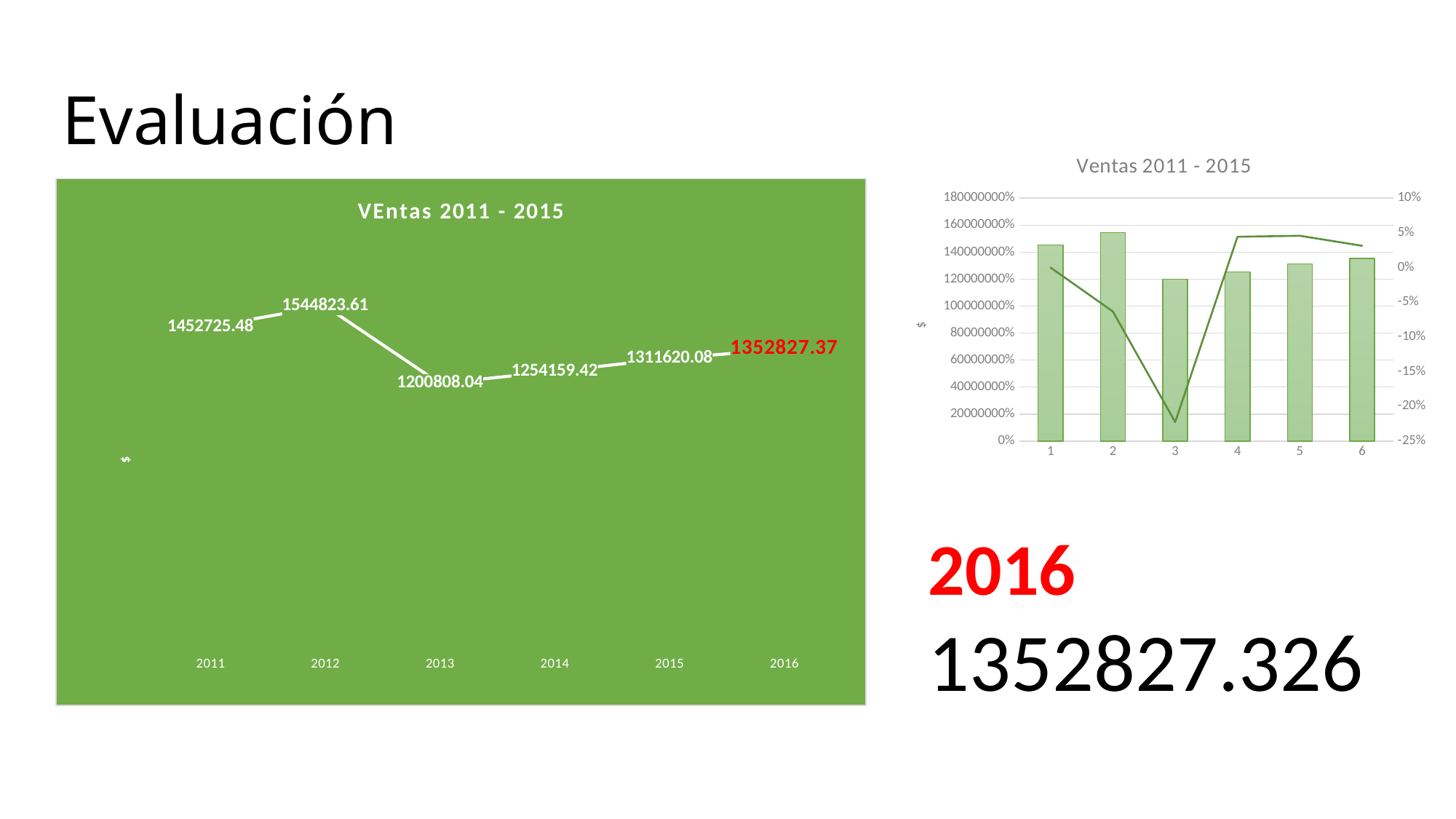
In the right chart titled 'Ventas 2011 - 2015', which category has the tallest bar? 2 In the left chart titled 'VEntas 2011 - 2015', which year has the highest value? 2012 In the left chart titled 'VEntas 2011 - 2015', how many years are plotted on the x axis? 6 In the right chart titled 'Ventas 2011 - 2015', is the bar for category 2 greater or less than 140000000%? greater In the left chart titled 'VEntas 2011 - 2015', do the values rise or fall from 2013 to 2016? Rise In the left chart titled 'VEntas 2011 - 2015', which is larger, the value for 2014 or the value for 2015? 2015 In the left chart titled 'VEntas 2011 - 2015', what is the value for 2016? 1352827.37 In the left chart titled 'VEntas 2011 - 2015', what is the difference between the 2012 and 2011 values? 92098.13 In the left chart titled 'VEntas 2011 - 2015', which year has the lowest value? 2013 In the left chart titled 'VEntas 2011 - 2015', what is the value for 2013? 1200808.04 In the left chart titled 'VEntas 2011 - 2015', which data label is shown in red? 1352827.37 What kind of chart is the left chart titled 'VEntas 2011 - 2015'? Line chart